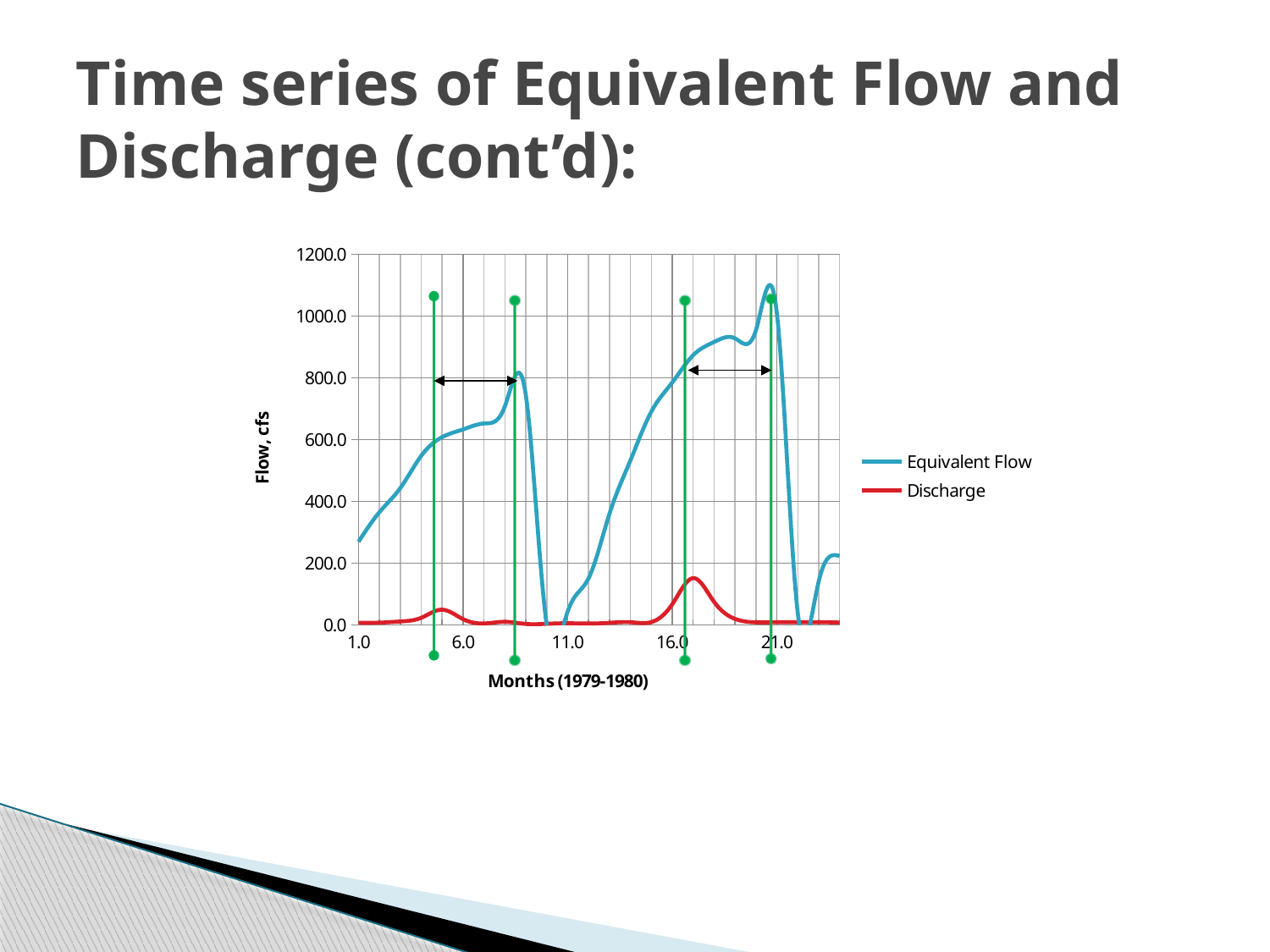
What are the two series named in the legend? Equivalent Flow and Discharge Does the Equivalent Flow series rise or fall between month 11.0 and month 16.0? rise Is the Equivalent Flow value at month 6.0 greater or less than 400.0? greater How many series does the legend list? 2 Is the Equivalent Flow value at month 11.0 greater or less than 200.0? less Which series reaches the highest value on the chart? Equivalent Flow At month 21.0, which series has the larger value, Equivalent Flow or Discharge? Equivalent Flow What is the title of the y axis? Flow, cfs Is the Equivalent Flow value at month 1.0 greater or less than 400.0? less What kind of chart is shown on the slide? line chart